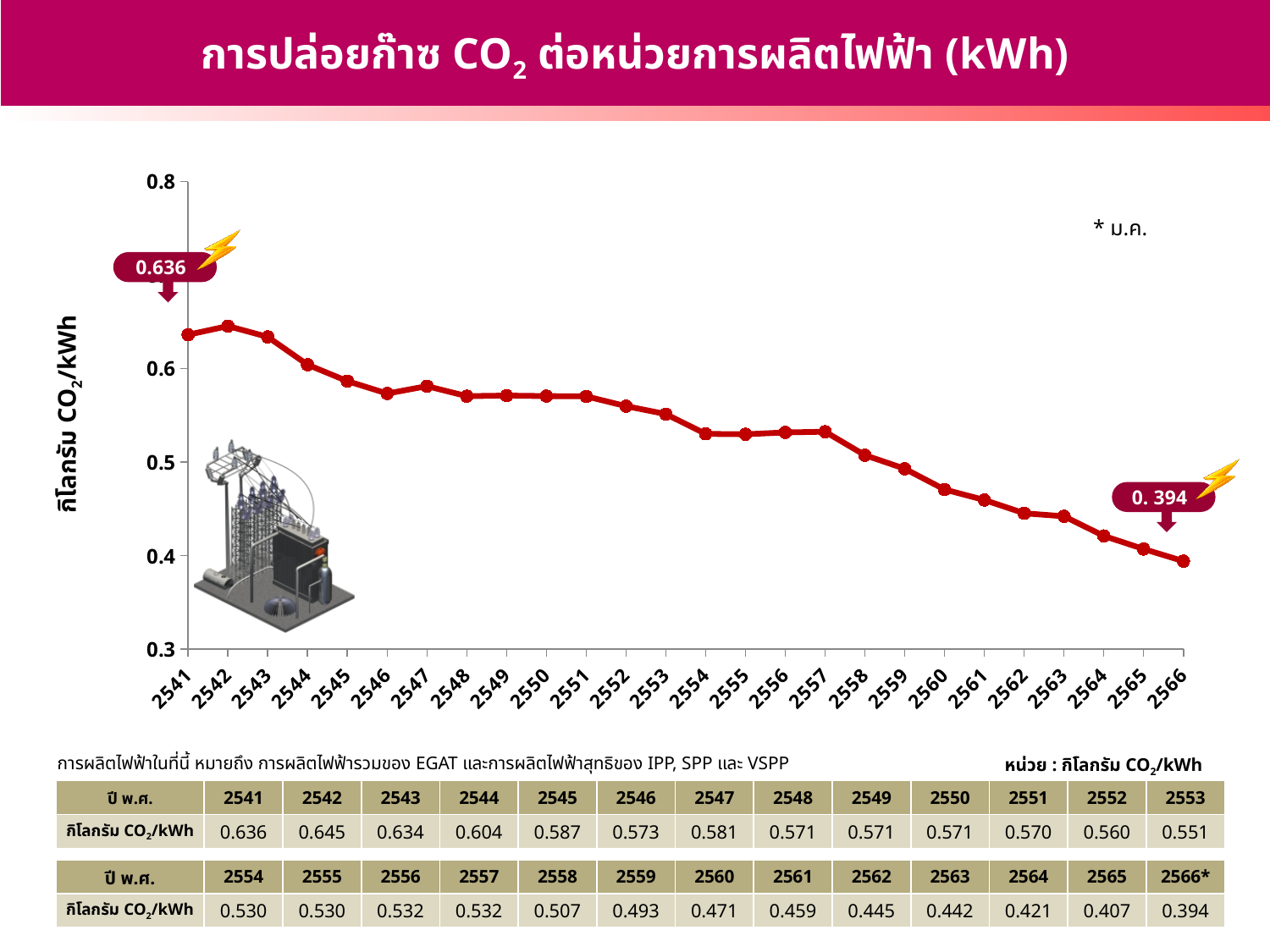
What is the value for year 2558? 0.507 Do the values generally rise or fall from 2541 to 2566? fall What is the difference between the values for 2541 and 2566? 0.242 Which year has the lowest value? 2566 What type of chart is shown on the slide? line chart What is the value for year 2541? 0.636 How many years are plotted on the chart? 26 What is the value for year 2566? 0.394 Which year has the highest value? 2542 Is the value for 2550 greater or less than 0.5? greater What is the difference between the values for 2542 and 2543? 0.011 Which is larger, the value for 2544 or the value for 2558? 2544